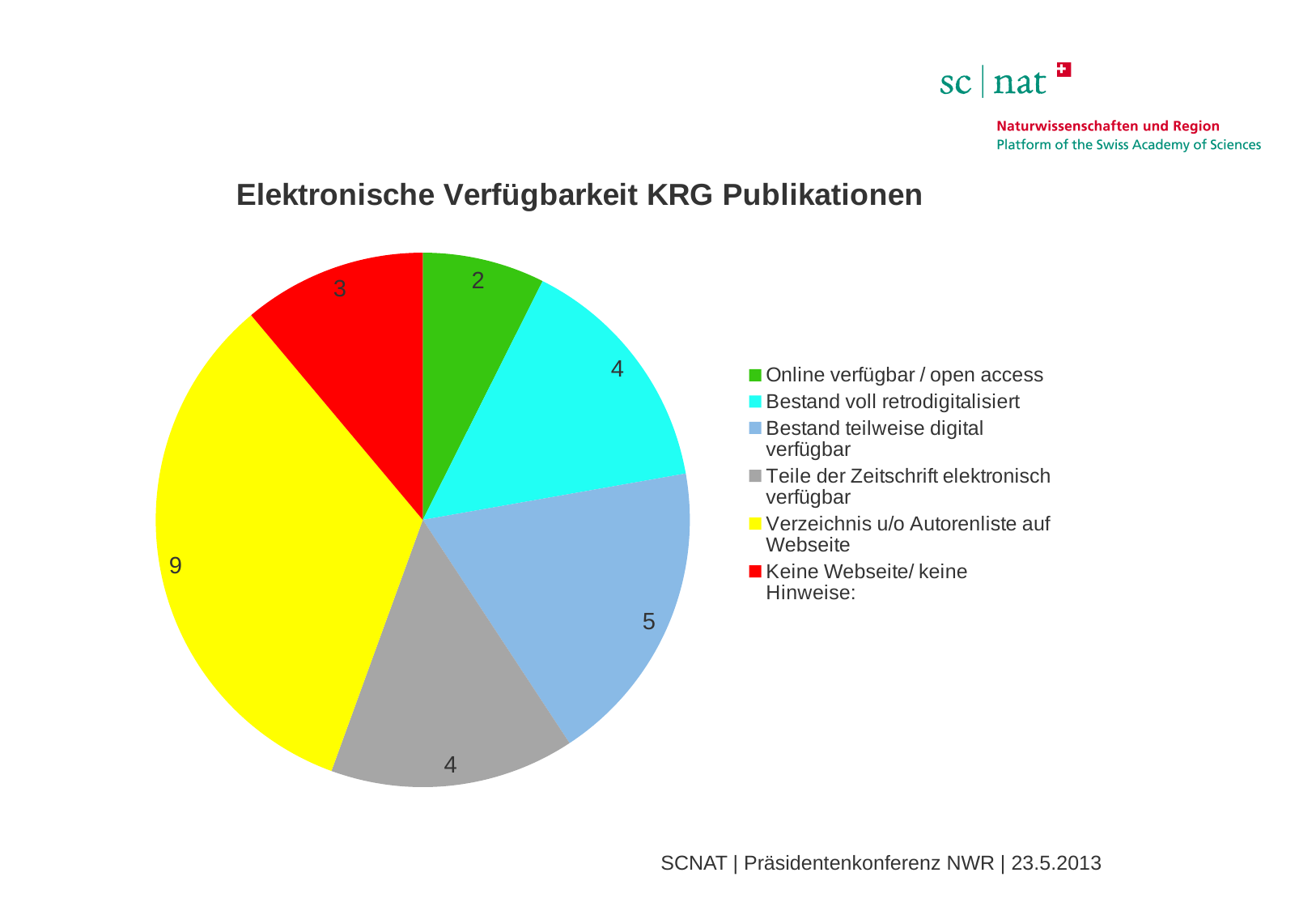
How many categories does the pie chart have? 6 What is the value for 'Verzeichnis u/o Autorenliste auf Webseite'? 9 What is the total of all the slice values in the pie chart? 27 What type of chart is shown on the slide? pie chart What is the value for 'Bestand teilweise digital verfügbar'? 5 What is the difference between the values for 'Verzeichnis u/o Autorenliste auf Webseite' and 'Keine Webseite/ keine Hinweise:'? 6 Which category has the largest slice of the pie? Verzeichnis u/o Autorenliste auf Webseite What is the value for 'Keine Webseite/ keine Hinweise:'? 3 Which category has the smallest slice of the pie? Online verfügbar / open access What is the value for 'Online verfügbar / open access'? 2 What is the title of the chart? Elektronische Verfügbarkeit KRG Publikationen Which is larger: the value for 'Bestand teilweise digital verfügbar' or the value for 'Bestand voll retrodigitalisiert'? Bestand teilweise digital verfügbar